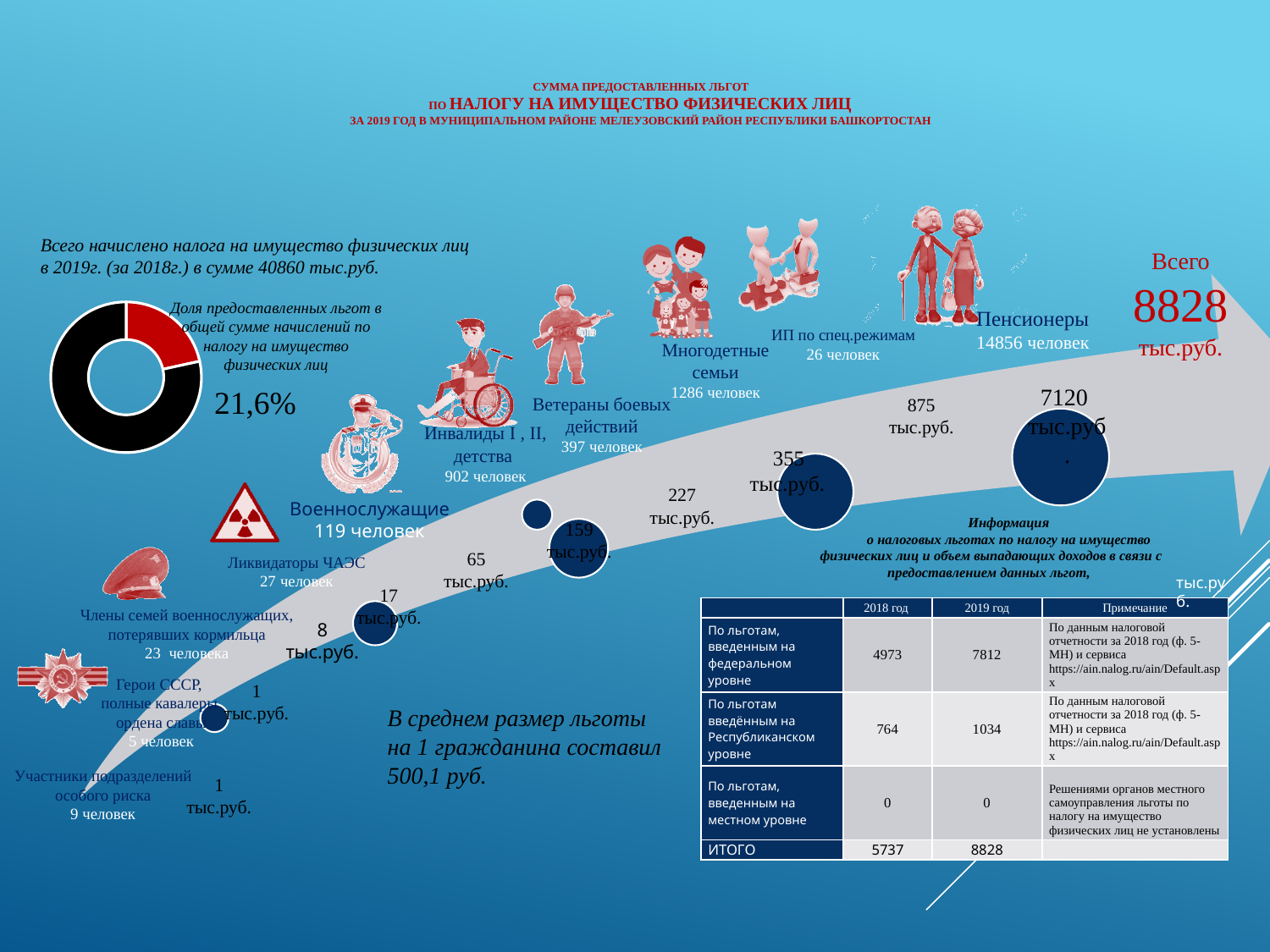
In the bubble diagram along the arrow, what is the total value shown at the tip of the arrow (Всего)? 8828 тыс.руб. How many slices does the donut chart have? 2 In the donut chart, which colour is the slice representing the 21,6% share of benefits? Red In the bubble diagram along the arrow, which category has the largest bubble value? Пенсионеры In the bubble diagram along the arrow, what is the value shown for ИП по спец.режимам? 875 тыс.руб. In the donut chart, what share of total property tax accruals do the provided benefits represent? 21,6% In the bubble diagram along the arrow, what is the difference between the values for Пенсионеры (7120 тыс.руб.) and ИП по спец.режимам (875 тыс.руб.)? 6245 тыс.руб. In the bubble diagram along the arrow, what is the value shown for Многодетные семьи? 355 тыс.руб. In the donut chart, is the red slice larger or smaller than the black slice? Smaller In the bubble diagram along the arrow, which is larger: the value for Ветераны боевых действий or the value for Военнослужащие? Ветераны боевых действий In the bubble diagram along the arrow, what is the value shown for Пенсионеры? 7120 тыс.руб. What kind of chart is shown on the left of the slide under the text about the share of benefits? Donut (pie) chart